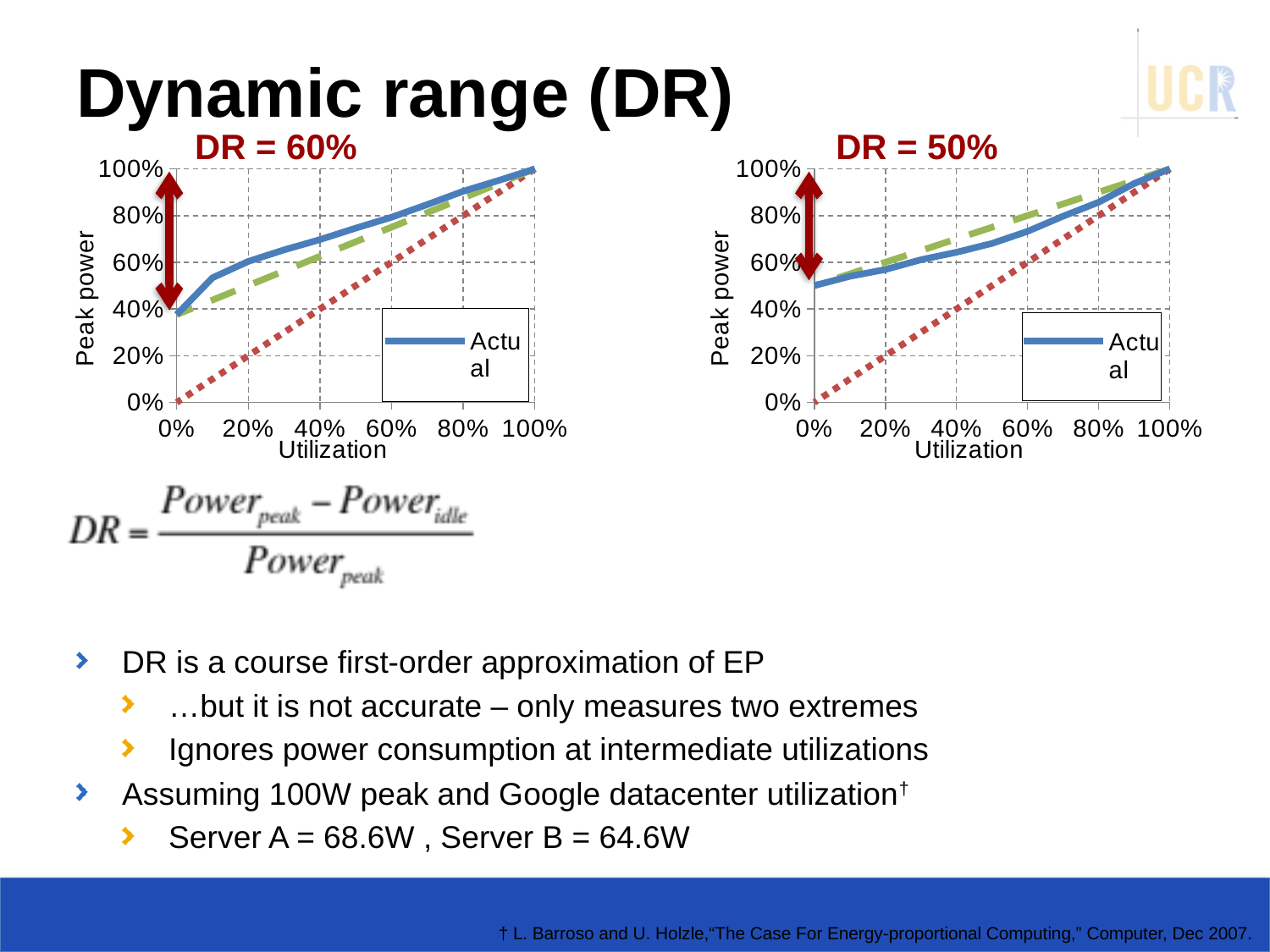
In the 'DR = 60%' chart, does the Actual peak power rise or fall as utilization increases? rise What is the y-axis title of the 'DR = 50%' chart? Peak power How many utilization tick labels are shown on the x axis of the 'DR = 50%' chart? 6 Which chart shows a higher Actual peak power at 0% utilization, 'DR = 60%' or 'DR = 50%'? DR = 50% In the 'DR = 60%' chart, what is the Actual peak power at 100% utilization? 100% In the 'DR = 60%' chart, is the Actual peak power at 20% utilization greater or less than 40%? greater In the 'DR = 50%' chart, is the Actual peak power at 0% utilization greater or less than 40%? greater What series name is shown in the legend of the 'DR = 60%' chart? Actual In the 'DR = 50%' chart, is the Actual peak power at 40% utilization greater or less than 80%? less What kind of chart is the 'DR = 60%' chart? line chart In the 'DR = 50%' chart, what is the Actual peak power at 100% utilization? 100%